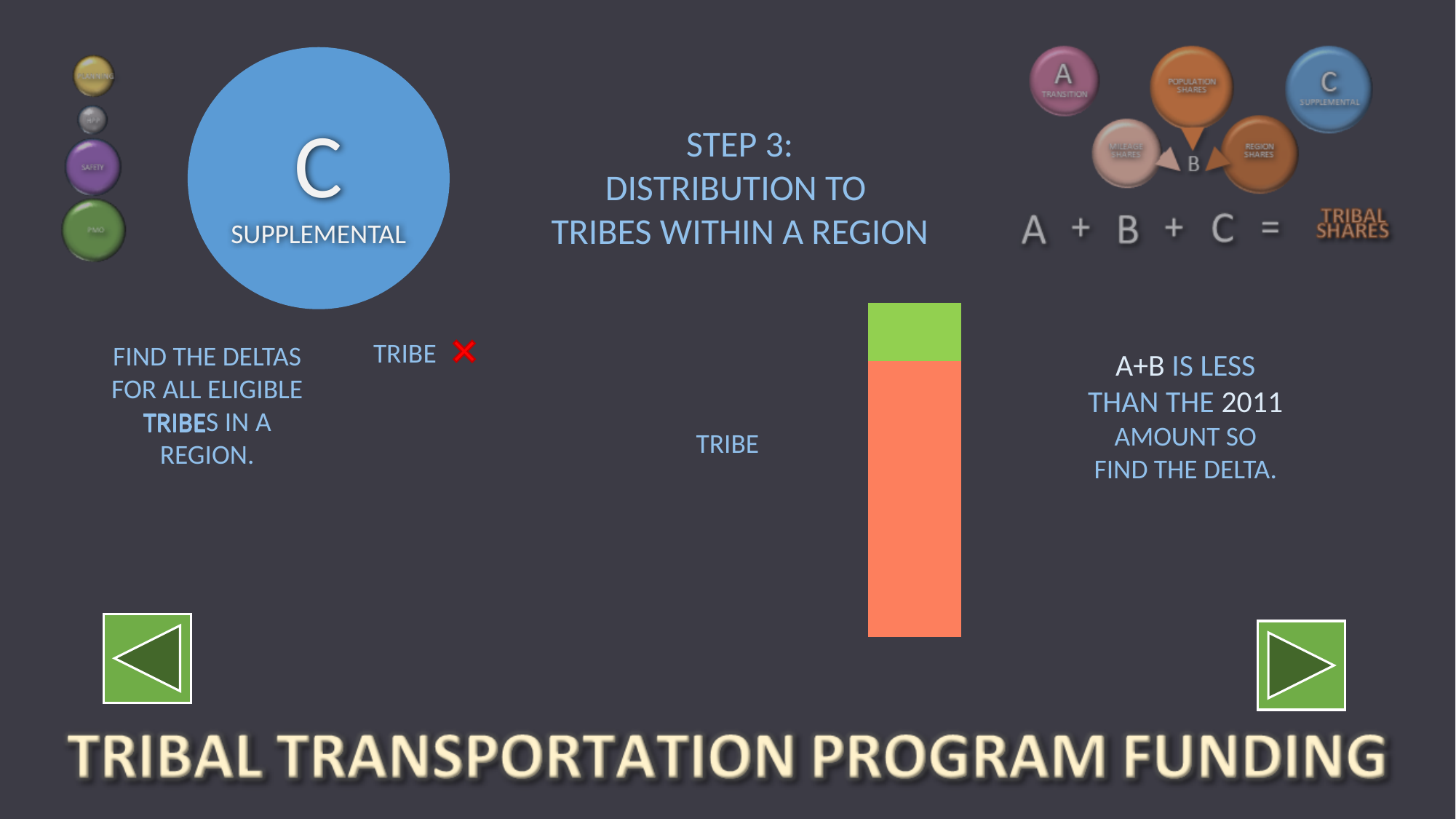
Which colour segment sits on top of the TRIBE bar? green How many bars does the chart show? 1 What kind of chart is shown in the middle of the slide? bar chart How many coloured segments make up the TRIBE bar? 2 Which segment of the TRIBE bar is larger, the orange segment or the green segment? orange